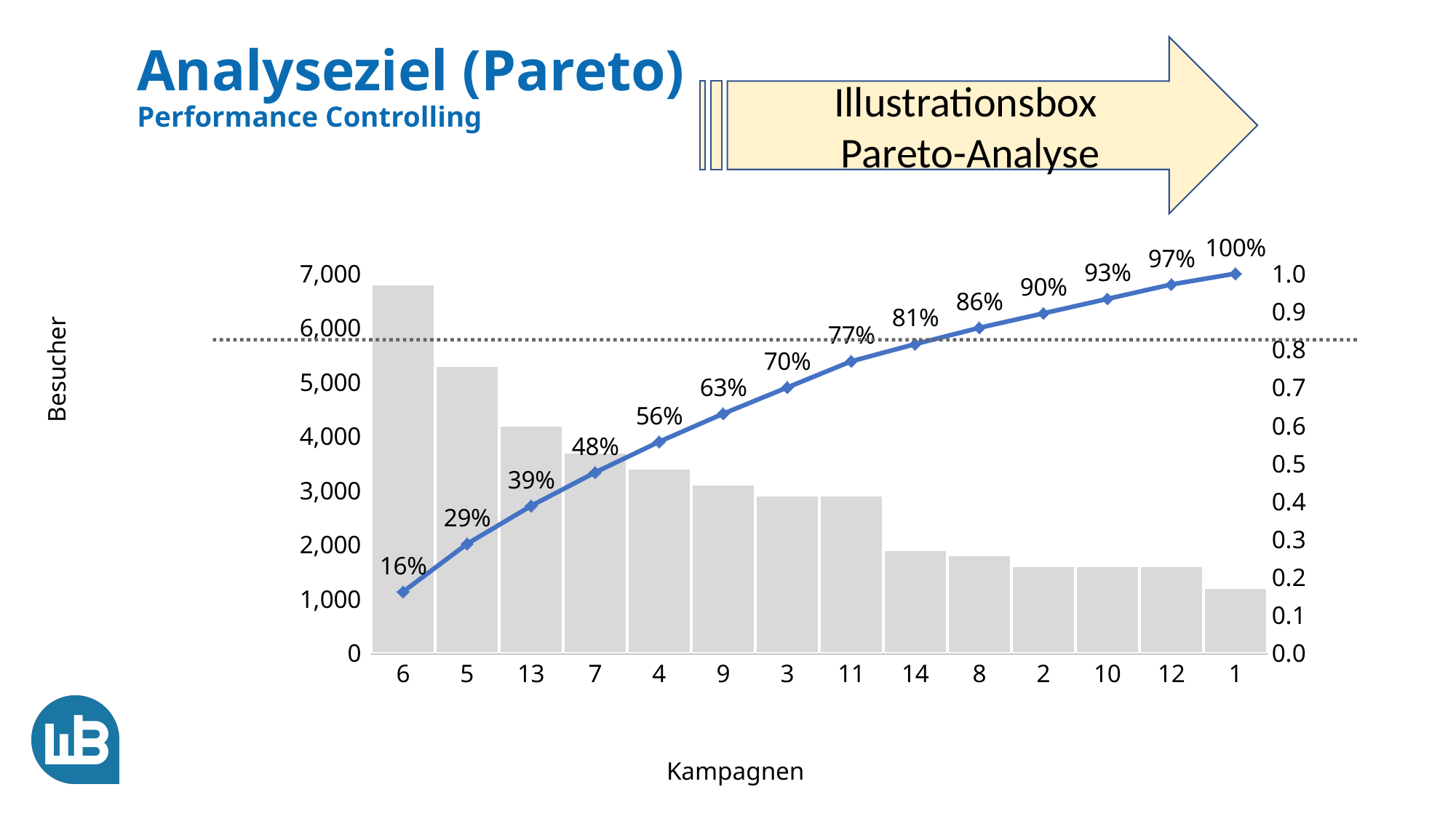
Which bar is taller, campaign 6 or campaign 5? Campaign 6 What is the title of the vertical axis on the left of the chart? Besucher What is the cumulative percentage shown for campaign 6, the first category on the x axis? 16% Which campaign has the lowest bar (fewest Besucher)? 1 What cumulative percentage is labelled at campaign 3? 70% Is the bar value for campaign 1 greater or less than 2,000? less What cumulative percentage is labelled at campaign 14? 81% Which campaign has the highest bar (most Besucher)? 6 Is the bar value for campaign 6 greater or less than 6,000? greater How many campaigns are shown on the x axis? 14 By how many percentage points does the cumulative line rise between campaign 6 (16%) and campaign 5 (29%)? 13 percentage points Does the cumulative percentage line rise or fall from left to right? It rises